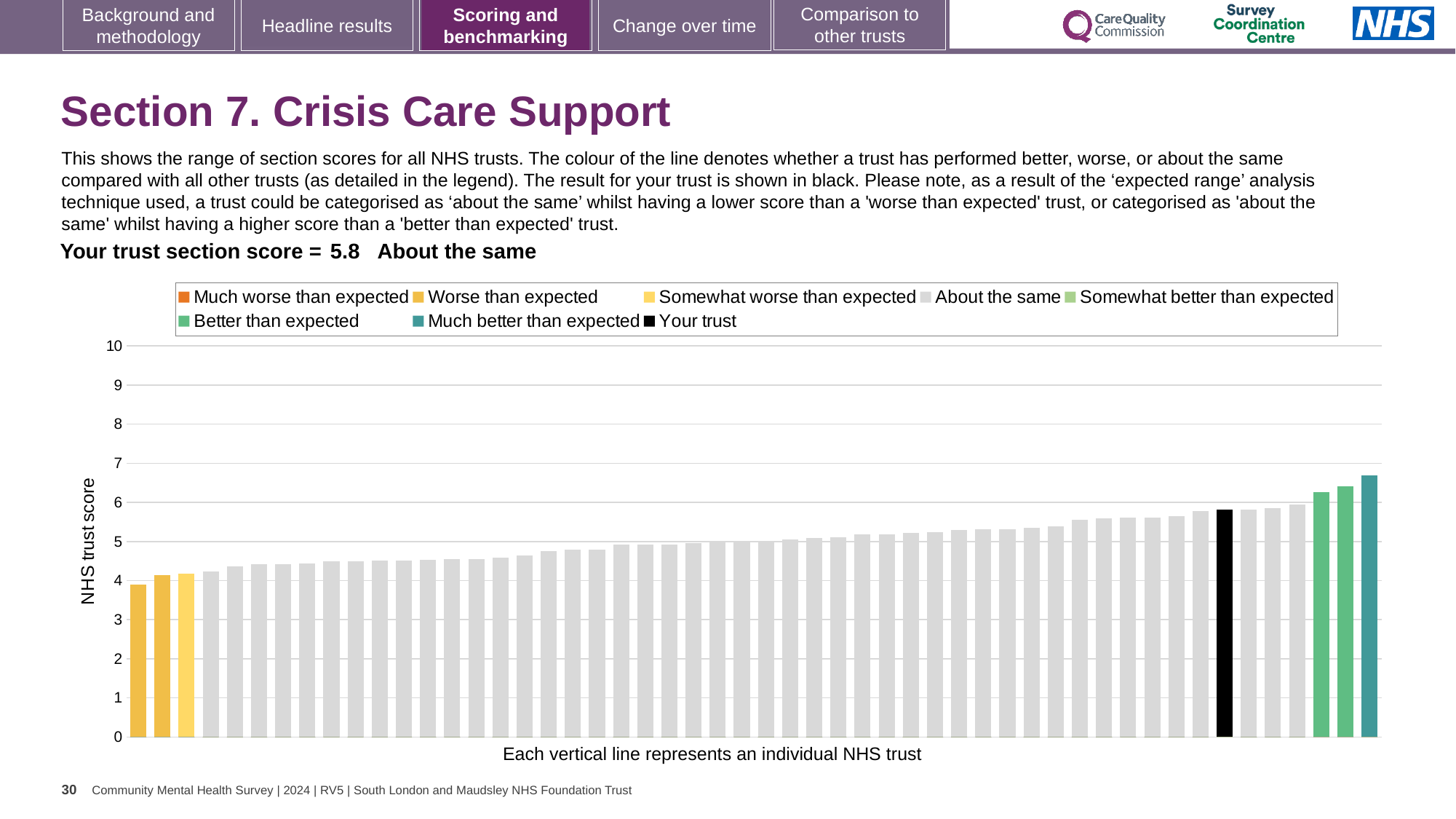
What is the section score for your trust shown on the slide? 5.8 Is the value of the tallest bar greater or less than 6? greater How many bars are coloured teal (much better than expected)? 1 Do the bar values rise or fall from left to right along the x axis? rise What colour is the bar representing your trust? black What is the label on the vertical axis of the chart? NHS trust score How many entries does the chart legend list? 8 What kind of chart is shown on the slide? bar chart Which is higher: the bar for your trust or the tallest bar on the chart? the tallest bar Is the value of the tallest bar greater or less than 7? less Is the value for your trust greater or less than 5? greater How many bars are coloured green (better than expected)? 2